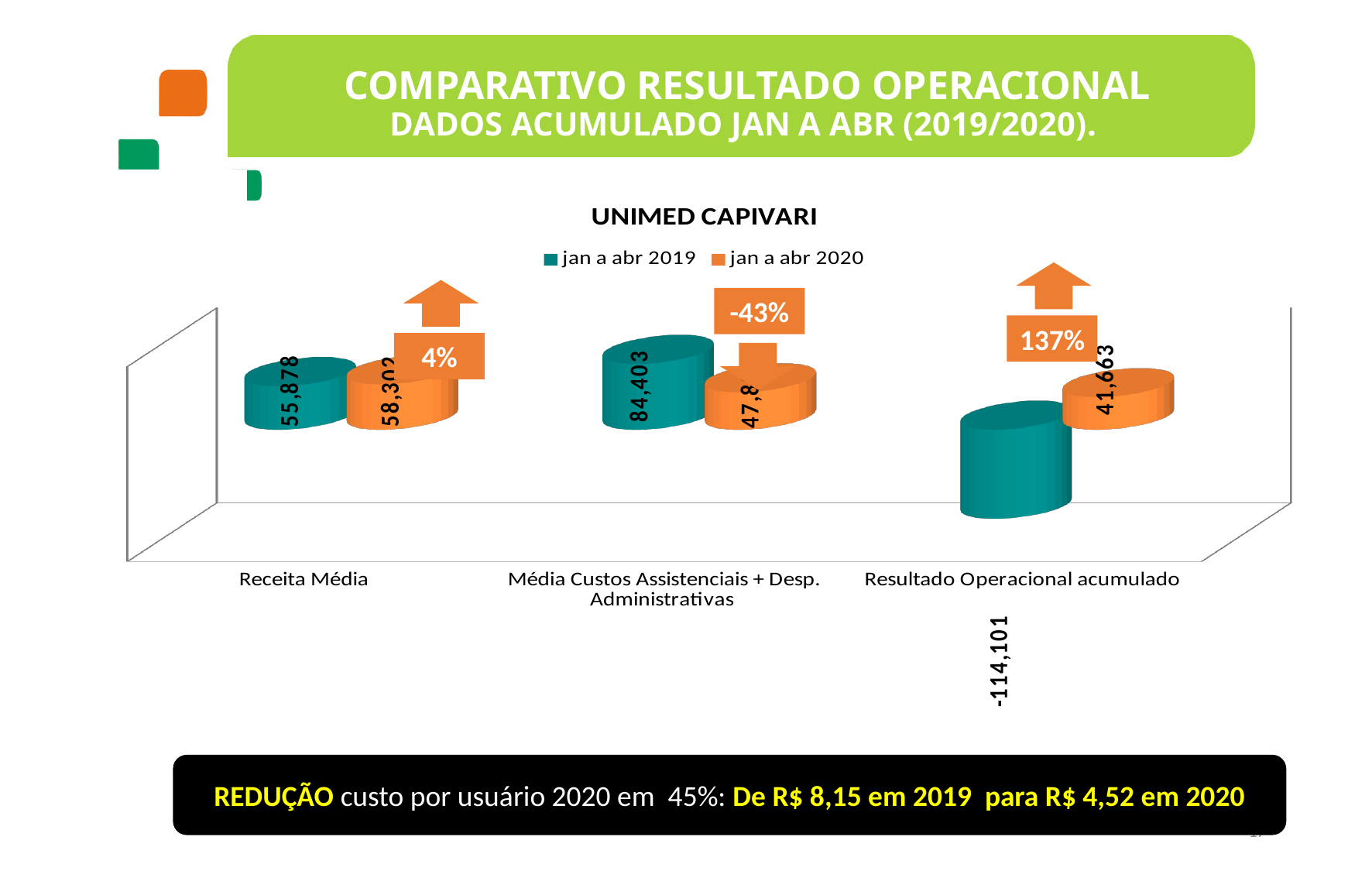
What is the difference between the jan a abr 2019 values for Média Custos Assistenciais + Desp. Administrativas and Receita Média? 28,525 What is the value for Média Custos Assistenciais + Desp. Administrativas in the jan a abr 2019 series? 84,403 What is the title of the chart? UNIMED CAPIVARI Which category has the highest value in the jan a abr 2019 series? Média Custos Assistenciais + Desp. Administrativas What kind of chart is shown on the slide? bar chart Which category has the lowest value in the jan a abr 2019 series? Resultado Operacional acumulado What is the value for Resultado Operacional acumulado in the jan a abr 2020 series? 41,663 What is the value for Resultado Operacional acumulado in the jan a abr 2019 series? -114,101 What is the value for Receita Média in the jan a abr 2019 series? 55,878 How many series does the chart legend list? 2 How many categories are shown on the x axis of the chart? 3 For Resultado Operacional acumulado, which series has the larger value, jan a abr 2019 or jan a abr 2020? jan a abr 2020